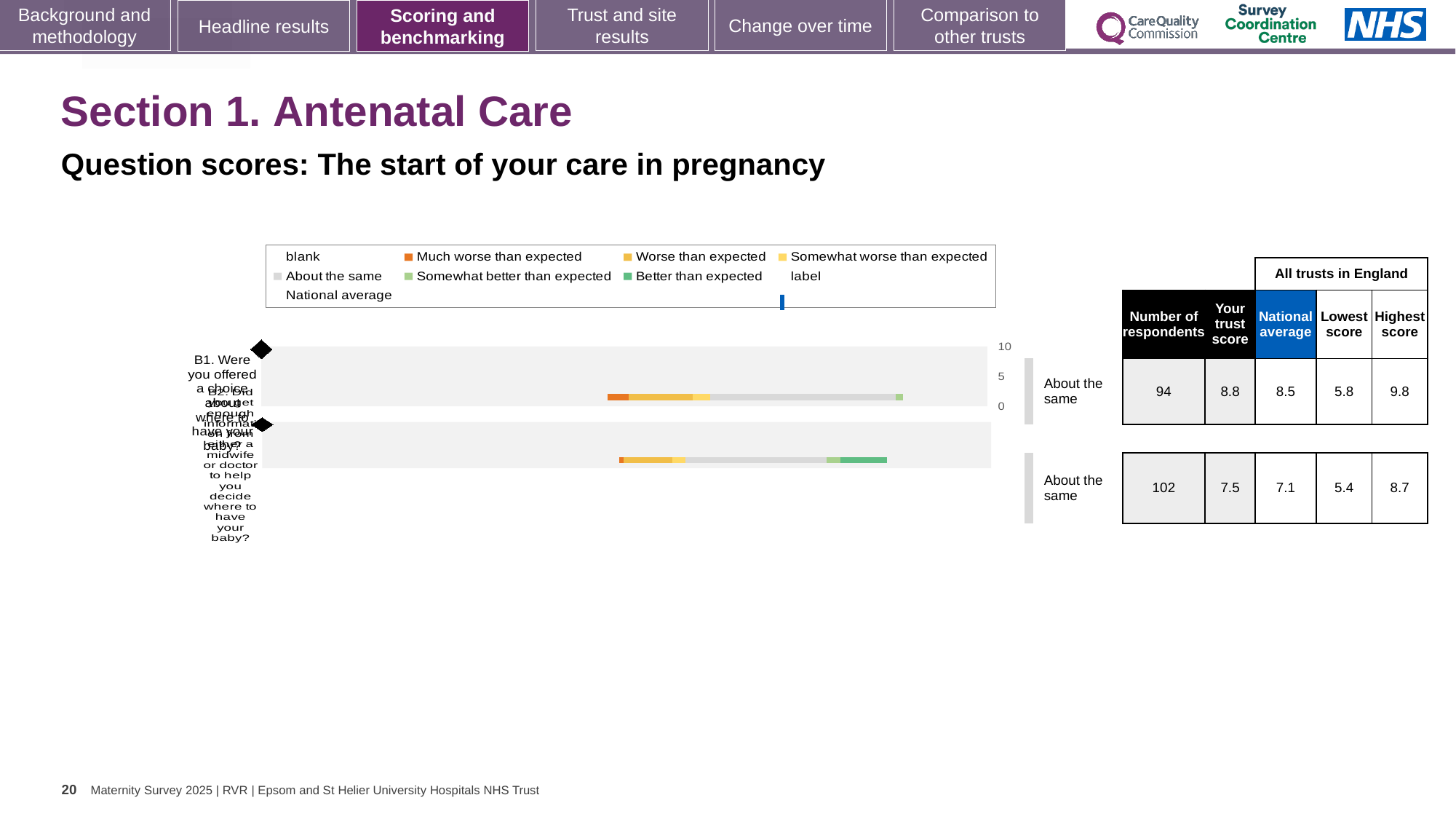
What is the difference between the highest score (9.8) and the lowest score (5.8) for B1? 4.0 In the table beside the chart, what is the national average for B2 'Did you get enough information from either a midwife or doctor to help you decide where to have your baby?' 7.1 In the table beside the chart, what is 'Your trust score' for B1 'Were you offered a choice about where to have your baby?' 8.8 In the chart legend, what does the blue marker represent? National average What kind of chart is shown on the slide? bar chart How many questions (bars) are plotted in the chart? 2 In the table beside the chart, how many respondents are recorded for B1 'Were you offered a choice about where to have your baby?' 94 In the table beside the chart, what is the highest score for B2? 8.7 Which question has the higher trust score, B1 or B2? B1 Which question has more respondents, B1 or B2? B2 In the chart legend, what colour represents 'Much worse than expected'? orange What benchmark category is shown next to the B1 bar? About the same